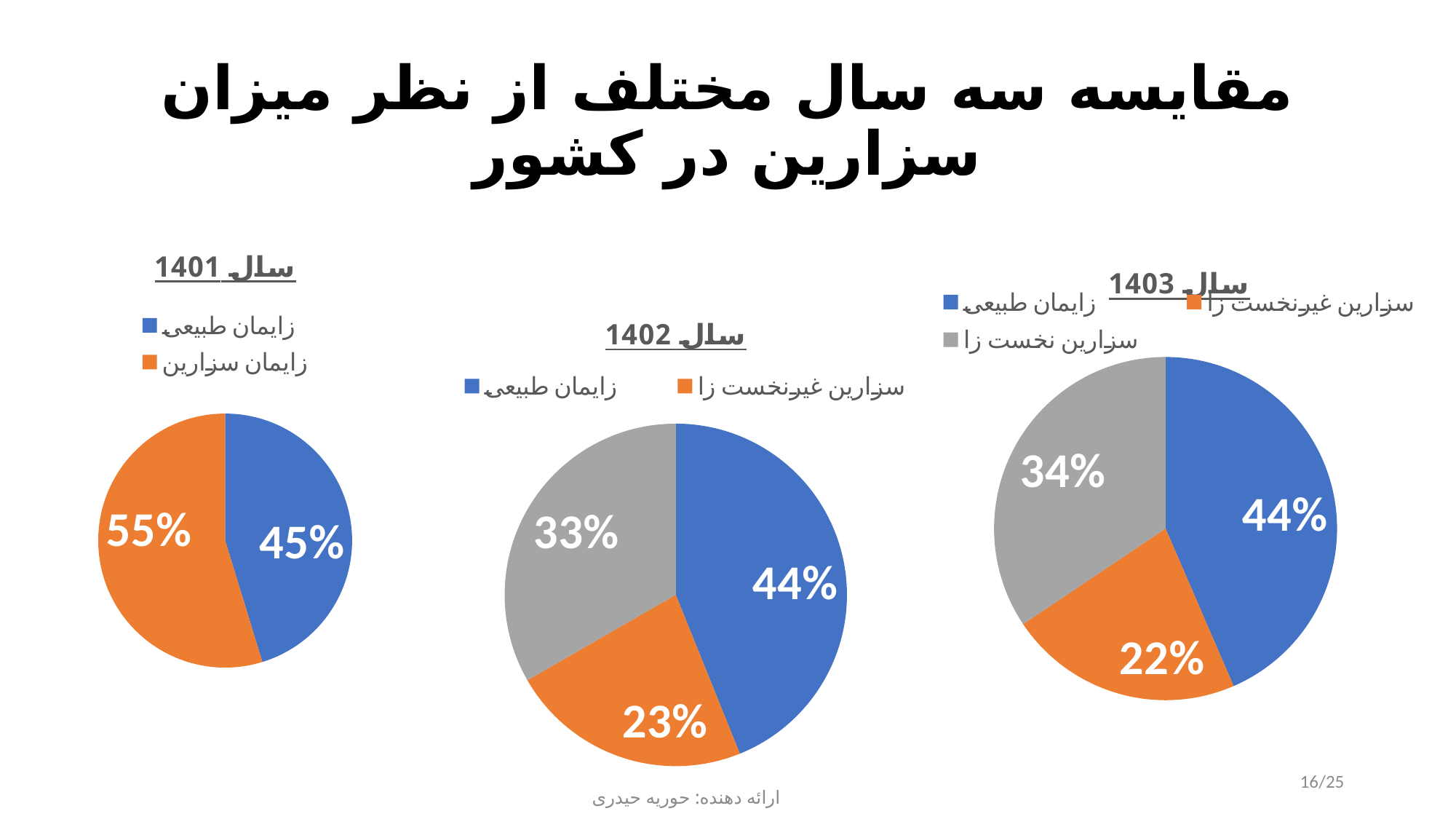
How many entries does the legend of the chart titled سال 1401 list? 2 In the chart titled سال 1403, which is larger: سزارین نخست زا or سزارین غیرنخست زا? سزارین نخست زا In the chart titled سال 1401, what is the difference between the زایمان سزارین share and the زایمان طبیعی share? 10% In the chart titled سال 1402, what share does سزارین غیرنخست زا have? 23% In the chart titled سال 1401, what share does زایمان طبیعی have? 45% In the chart titled سال 1403, what share does زایمان طبیعی have? 44% In the chart titled سال 1403, which category has the smallest slice? سزارین غیرنخست زا In the chart titled سال 1402, which category has the largest slice? زایمان طبیعی In the chart titled سال 1402, what share does سزارین نخست زا have? 33% How many slices does the chart titled سال 1402 have? 3 What type of chart is the chart titled سال 1403? pie chart In the chart titled سال 1401, what share does زایمان سزارین have? 55%